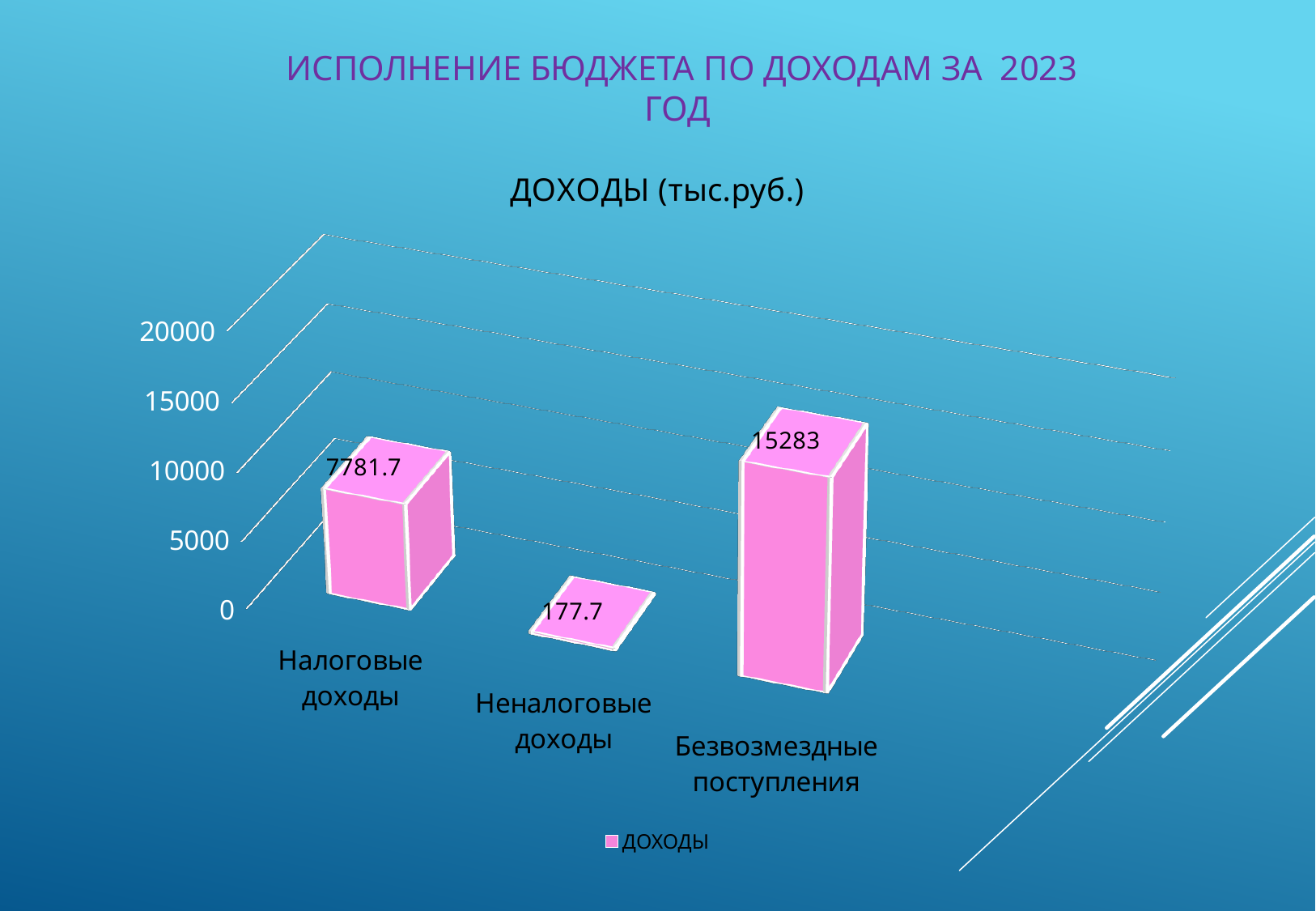
Which category has the lowest value? Неналоговые доходы What is the difference between Безвозмездные поступления and Налоговые доходы? 7501.3 What is the value for Неналоговые доходы? 177.7 What is the title of the chart? ДОХОДЫ (тыс.руб.) What is the value for Налоговые доходы? 7781.7 What is the value for Безвозмездные поступления? 15283 Which category has the highest value? Безвозмездные поступления What kind of chart is shown on the slide? bar chart How many categories are shown in the chart? 3 Is the value for Безвозмездные поступления greater or less than 10000? greater How many series does the legend list? 1 Which is larger, Налоговые доходы or Неналоговые доходы? Налоговые доходы